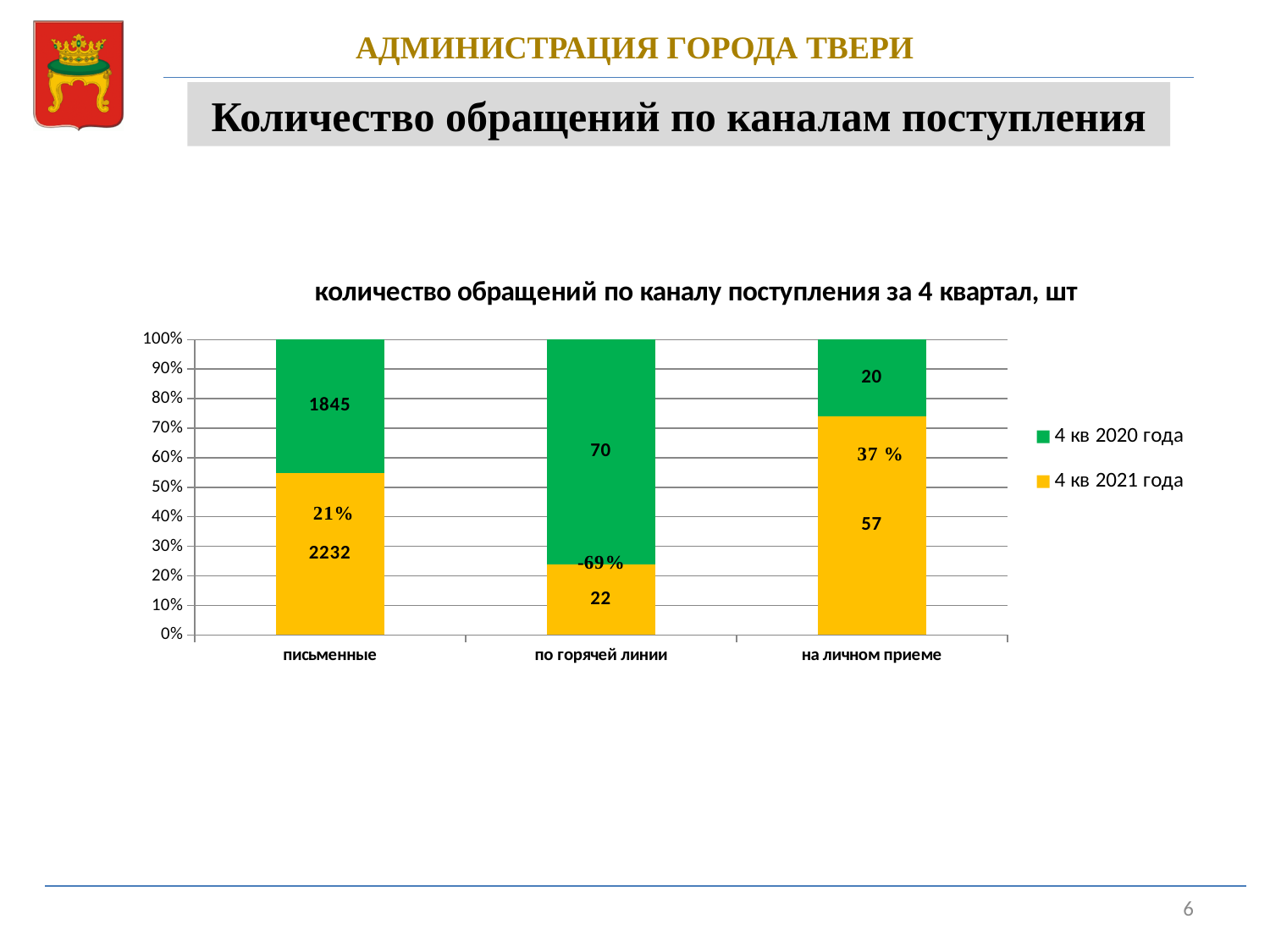
What is the value for на личном приеме in the 4 кв 2021 года series? 57 Is the share of the 4 кв 2021 года segment for по горячей линии greater or less than 30%? less What kind of chart is shown on the slide? stacked bar chart Which category has the lowest value in the 4 кв 2021 года series? по горячей линии How many categories are shown on the x axis? 3 How many series does the legend list? 2 What is the title of the chart? количество обращений по каналу поступления за 4 квартал, шт What is the difference between the 4 кв 2021 года and 4 кв 2020 года values for письменные? 387 Which category has the highest value in the 4 кв 2020 года series? письменные What is the value for по горячей линии in the 4 кв 2020 года series? 70 What is the value for письменные in the 4 кв 2021 года series? 2232 For на личном приеме, which is larger: the 4 кв 2020 года value or the 4 кв 2021 года value? 4 кв 2021 года